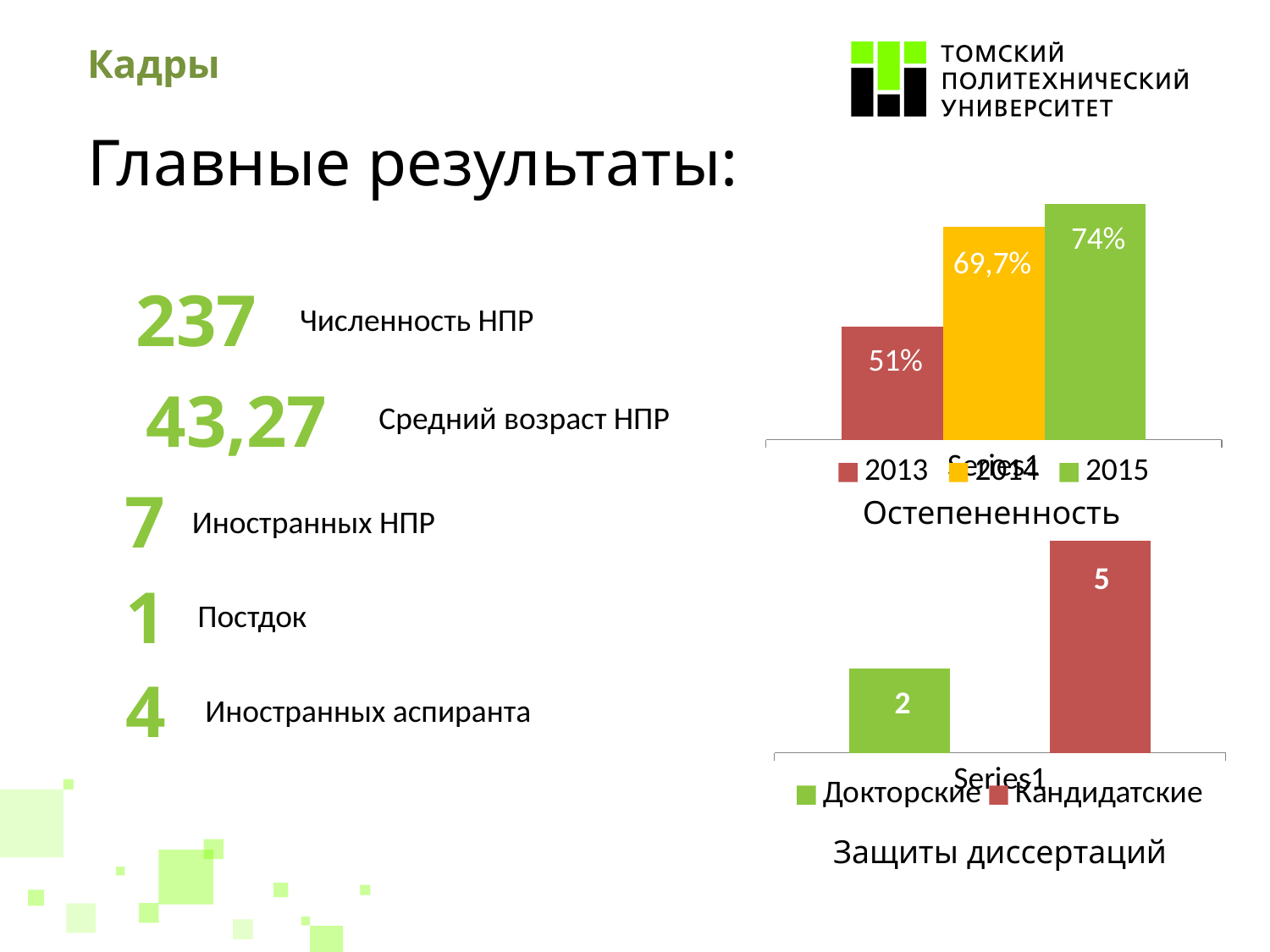
In the Защиты диссертаций chart, what is the value for Кандидатские? 5 In the Остепененность chart, which year has the highest value? 2015 In the Остепененность chart, which year has the lowest value? 2013 In the Защиты диссертаций chart, what is the difference between Кандидатские and Докторские? 3 What type of chart is the Защиты диссертаций chart? bar chart In the Остепененность chart, do the values rise or fall from 2013 to 2015? rise In the Защиты диссертаций chart, what is the value for Докторские? 2 In the Остепененность chart, what is the value for 2013? 51% In the Защиты диссертаций chart, which is larger, Докторские or Кандидатские? Кандидатские In the Остепененность chart, how many series does the legend list? 3 In the Остепененность chart, what is the value for 2015? 74% In the Остепененность chart, what is the value for 2014? 69,7%